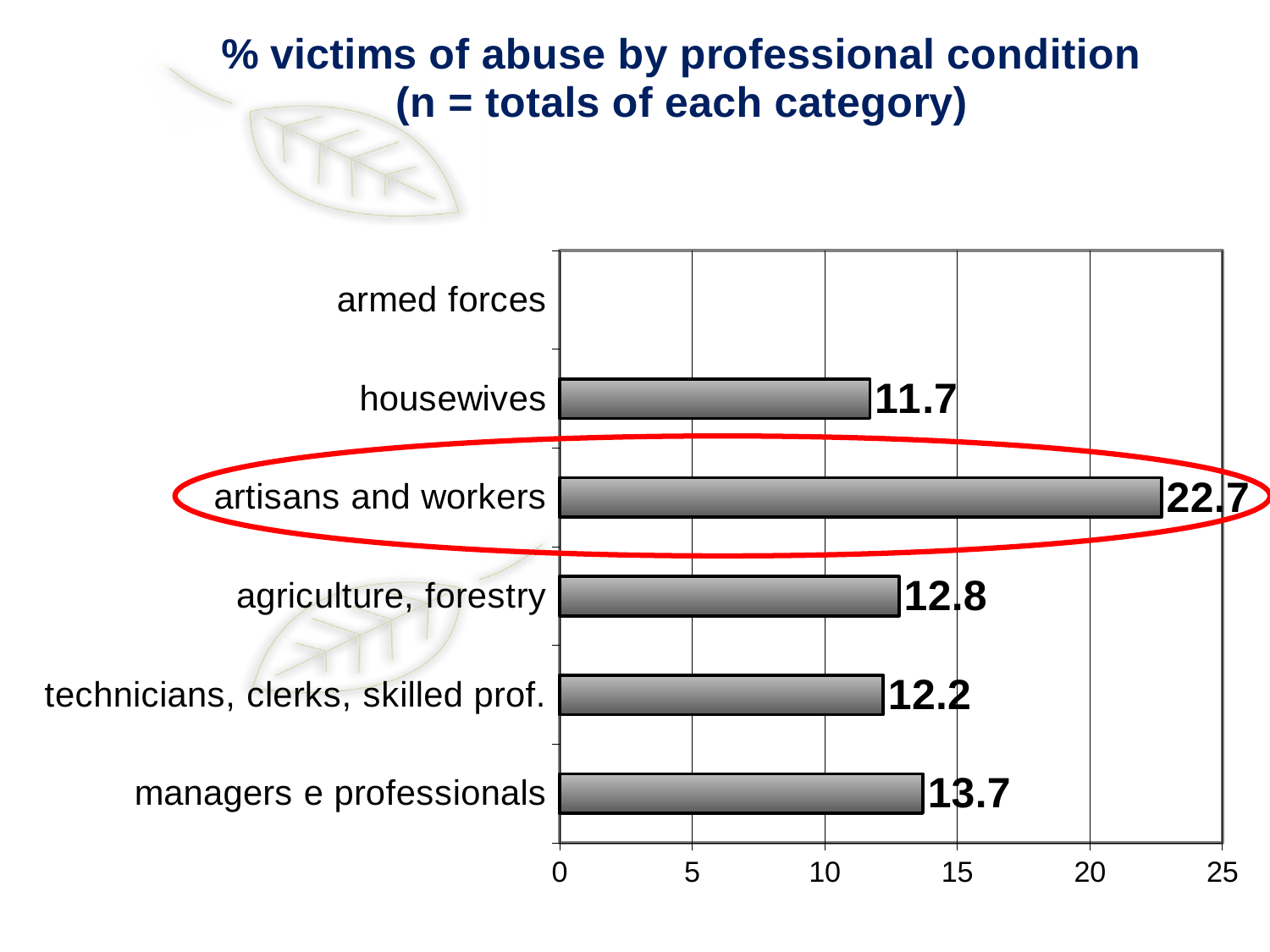
What kind of chart is shown on the slide? bar chart Among the categories with a plotted bar, which has the lowest value? housewives What is the difference between the values for artisans and workers and housewives? 11.0 How many categories are listed on the vertical axis? 6 Which category has the highest value? artisans and workers What is the value for agriculture, forestry? 12.8 What is the value for artisans and workers? 22.7 Is the value for artisans and workers greater or less than 20? greater What is the value for managers e professionals? 13.7 Which is larger, the value for agriculture, forestry or the value for technicians, clerks, skilled prof.? agriculture, forestry What is the value for housewives? 11.7 Which category is circled in red on the chart? artisans and workers